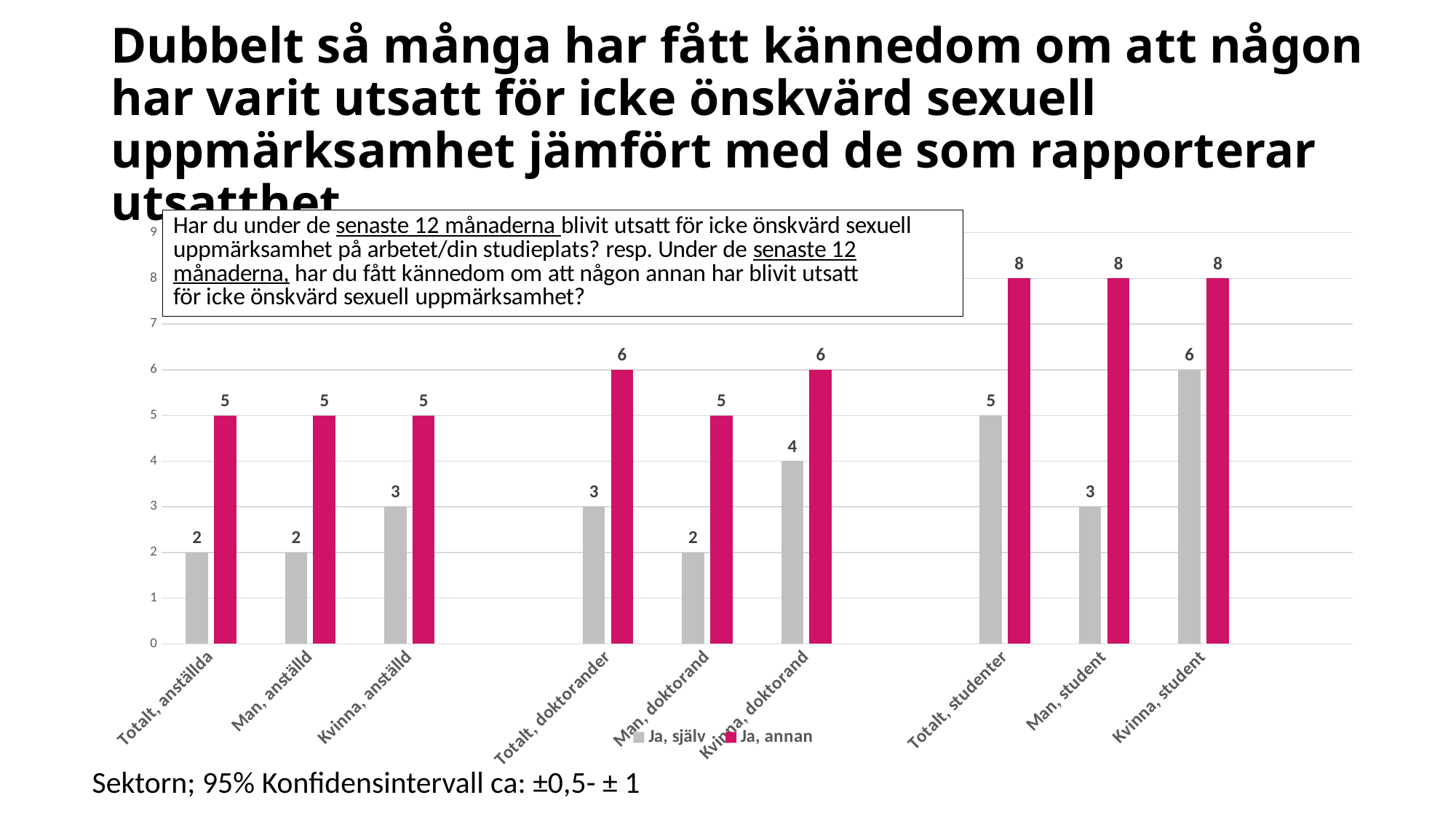
What is the value of "Ja, själv" for Kvinna, student? 6 What is the difference between "Ja, annan" and "Ja, själv" for Man, student? 5 How many categories are shown on the x axis? 9 What is the value of "Ja, själv" for Man, doktorand? 2 How many series does the legend list? 2 Which colour represents the "Ja, annan" series? Magenta/pink What is the value of "Ja, annan" for Totalt, studenter? 8 Which category has the highest value for "Ja, själv"? Kvinna, student What kind of chart is shown on the slide? Bar chart What is the value of "Ja, annan" for Totalt, doktorander? 6 Which category has the lowest value for "Ja, annan"? Totalt, anställda, Man, anställd, Kvinna, anställd and Man, doktorand (all 5) Which is larger for Kvinna, doktorand: "Ja, själv" or "Ja, annan"? Ja, annan